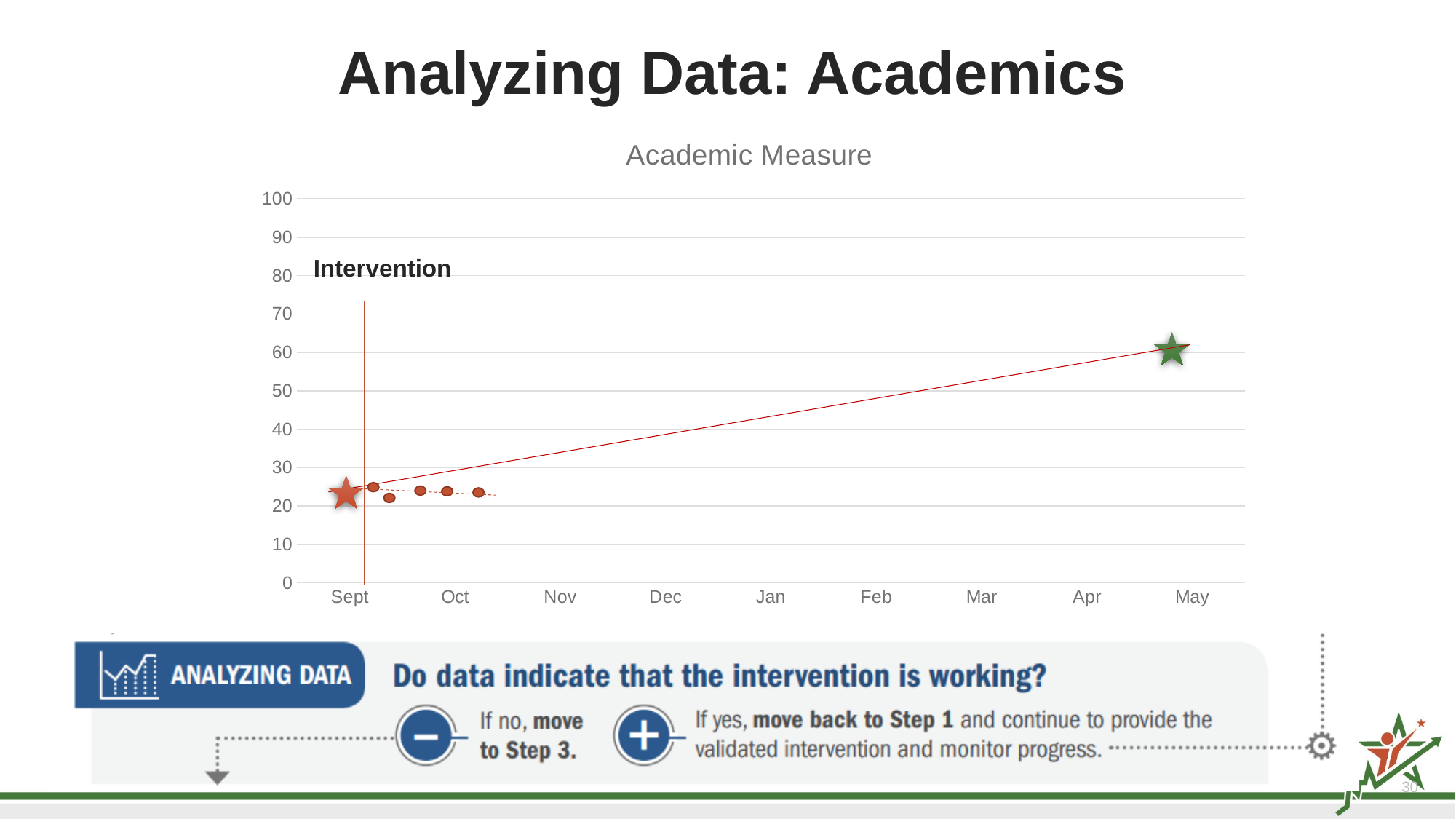
What kind of chart is shown on the slide? line chart Is the value of the green star at May greater or less than 50? greater Is the value of the green star at May greater or less than 70? less How many months are labelled along the x axis of the chart? 9 Is the value of the red star at Sept greater or less than 30? less Which is higher, the green star at May or the red star at Sept? the green star at May What is the highest value shown on the y axis? 100 What is the first month labelled on the x axis? Sept What is the title of the chart? Academic Measure Does the red goal line rise or fall from Sept to May? rises What label is written next to the vertical red line near Sept? Intervention